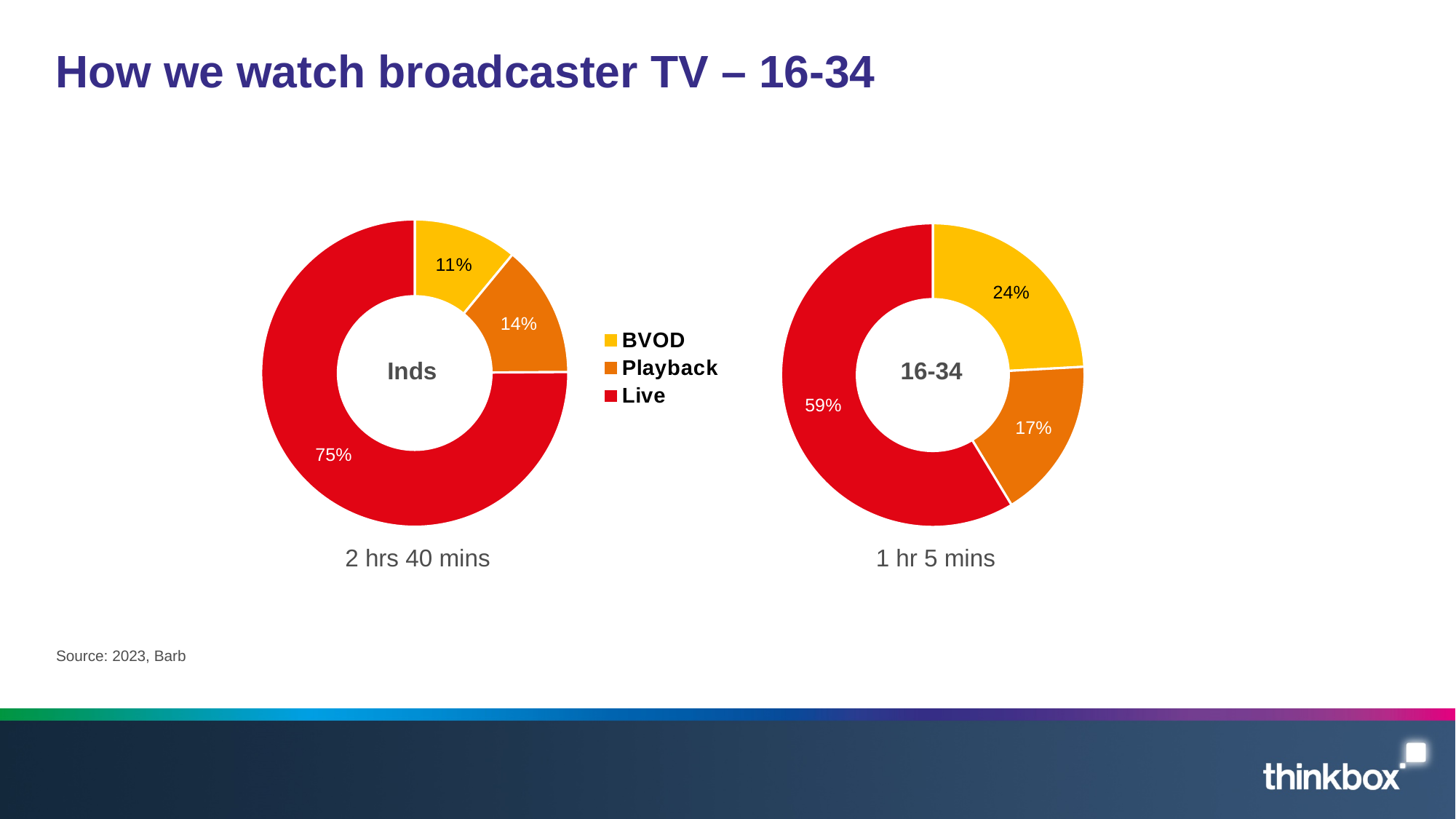
Is the BVOD share larger in the Inds chart or the 16-34 chart? 16-34 In the Inds donut chart, what share is BVOD? 11% In the 16-34 donut chart, what share is BVOD? 24% Which colour represents Playback in the legend? Orange What viewing time is shown below the 16-34 donut chart? 1 hr 5 mins How many categories does the legend list? 3 In the 16-34 donut chart, which category has the smallest share? Playback What is the difference between the Live share in the Inds chart and the Live share in the 16-34 chart? 16 percentage points In the Inds donut chart, what share is Live? 75% What type of chart is used on this slide? Donut (pie) chart In the 16-34 donut chart, what share is Playback? 17% In the Inds donut chart, which category has the largest share? Live